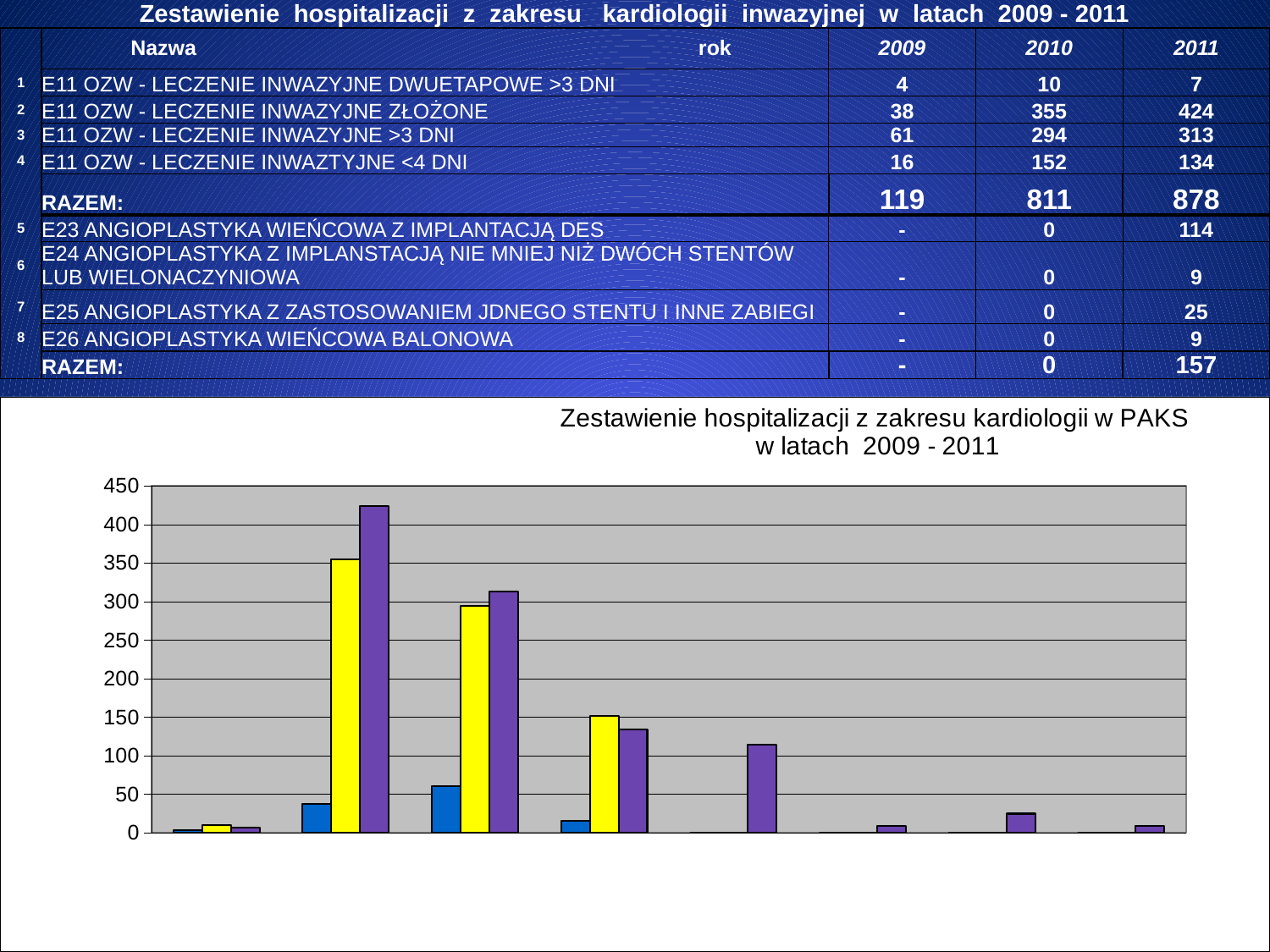
Is the purple bar in the fourth group from the left greater or less than 150? less How many groups of bars are plotted along the x axis of the chart? 8 Is the purple bar in the second group greater or less than 350? greater What kind of chart is shown at the bottom of the slide? bar chart What is the title of the chart at the bottom of the slide? Zestawienie hospitalizacji z zakresu kardiologii w PAKS w latach 2009 - 2011 What is the highest value shown on the chart's vertical axis? 450 Is the tallest bar in the chart greater or less than 400? greater Which is taller in the chart: the yellow bar in the second group or the yellow bar in the third group? the yellow bar in the second group Which group of bars (counting from the left) contains the tallest bar in the chart? the second group